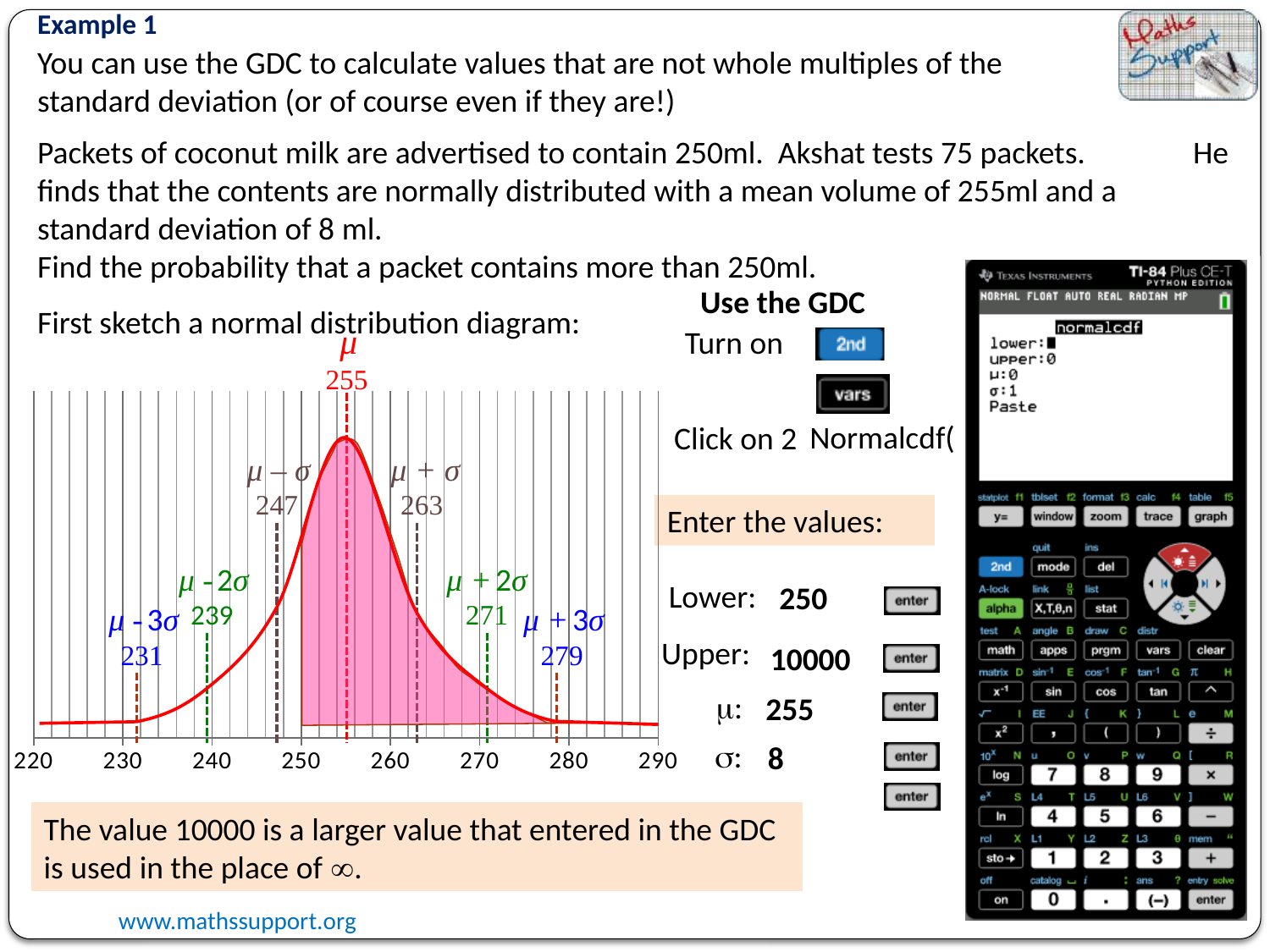
What value is labelled at μ + 3σ on the diagram? 279 What value is labelled at μ − 2σ on the diagram? 239 What value is labelled at the mean μ on the normal distribution diagram? 255 What value is labelled at μ + σ on the diagram? 263 What is the difference between the values labelled at μ + σ and μ − σ? 16 What colour is the shaded region under the curve? pink What value is labelled at μ − 3σ on the diagram? 231 At which labelled x value does the curve reach its peak? 255 What kind of chart is shown on the slide? line chart (normal distribution curve) What value is labelled at μ − σ on the diagram? 247 How many numbered tick labels are shown on the x axis of the diagram? 8 What is the difference between the values labelled at μ + 3σ and μ − 3σ? 48